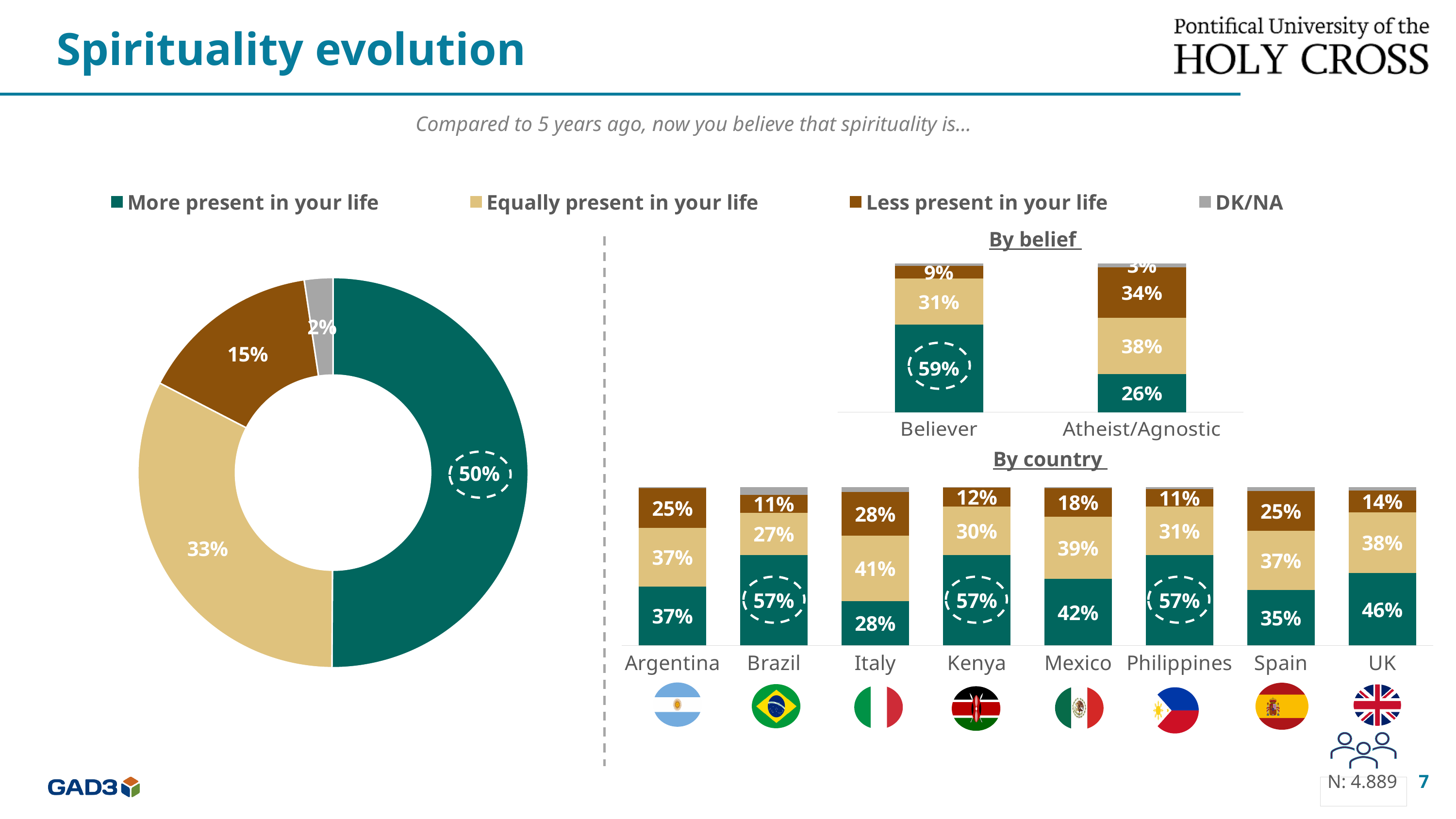
In the 'By country' chart, which country has the lowest share for 'More present in your life'? Italy In the doughnut chart on the left, what is the share for 'Less present in your life'? 15% In the 'By country' chart, which has the larger 'More present in your life' share, the UK or Spain? UK How many countries are shown in the 'By country' chart? 8 In the 'By country' chart, what is the difference between Argentina's and Brazil's 'Less present in your life' shares? 14 percentage points In the 'By belief' chart, what is the difference in the 'More present in your life' share between Believers and Atheist/Agnostic respondents? 33 percentage points In the 'By belief' chart, what percentage of Believers said spirituality is more present in their life? 59% In the 'By belief' chart, what percentage of Atheist/Agnostic respondents said spirituality is less present in their life? 34% How many series does the legend at the top of the slide list? 4 In the doughnut chart on the left, what share of respondents said spirituality is more present in their life? 50% In the 'By country' chart, what percentage of respondents in Italy said spirituality is more present in their life? 28% What kind of chart is the chart on the left of the slide? Doughnut (pie) chart